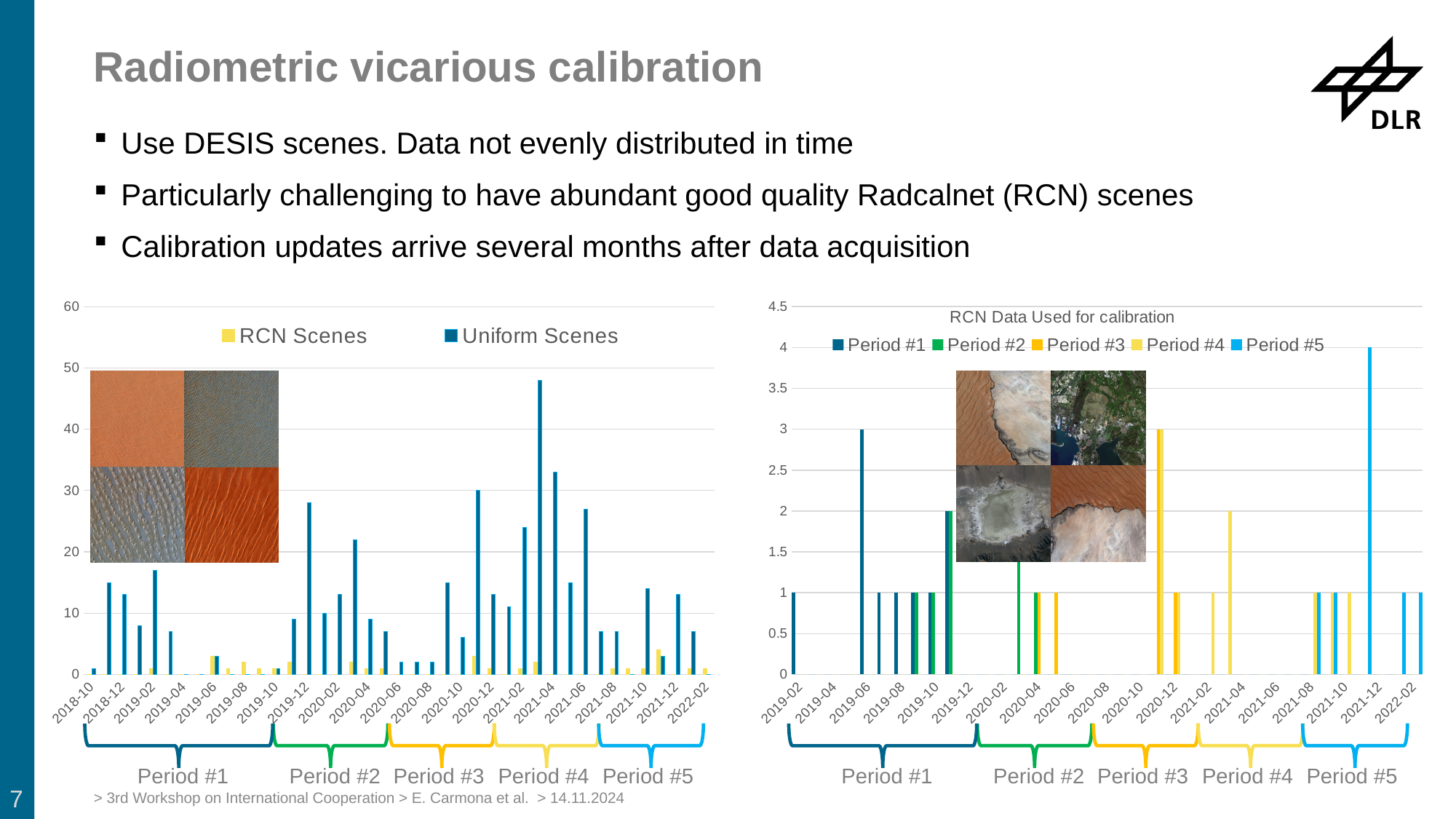
How many series does the legend of the left chart list? 2 In the 'RCN Data Used for calibration' chart, what is the value of the Period #3 bar at 2020-12? 1 In the 'RCN Data Used for calibration' chart, what is the highest value reached by any bar? 4 What is the title of the right chart? RCN Data Used for calibration How many series does the legend of the 'RCN Data Used for calibration' chart list? 5 In the 'RCN Data Used for calibration' chart, what is the value of the Period #1 bar at 2019-06? 3 In the left chart, is the Uniform Scenes value at 2019-12 greater or less than 20? greater What kind of chart is the left chart on the slide? bar chart In the 'RCN Data Used for calibration' chart, which period does the tallest bar belong to? Period #5 In the left chart, which series generally has the taller bars, RCN Scenes or Uniform Scenes? Uniform Scenes What are the two series named in the legend of the left chart? RCN Scenes and Uniform Scenes In the left chart, is the tallest Uniform Scenes bar greater or less than 40? greater